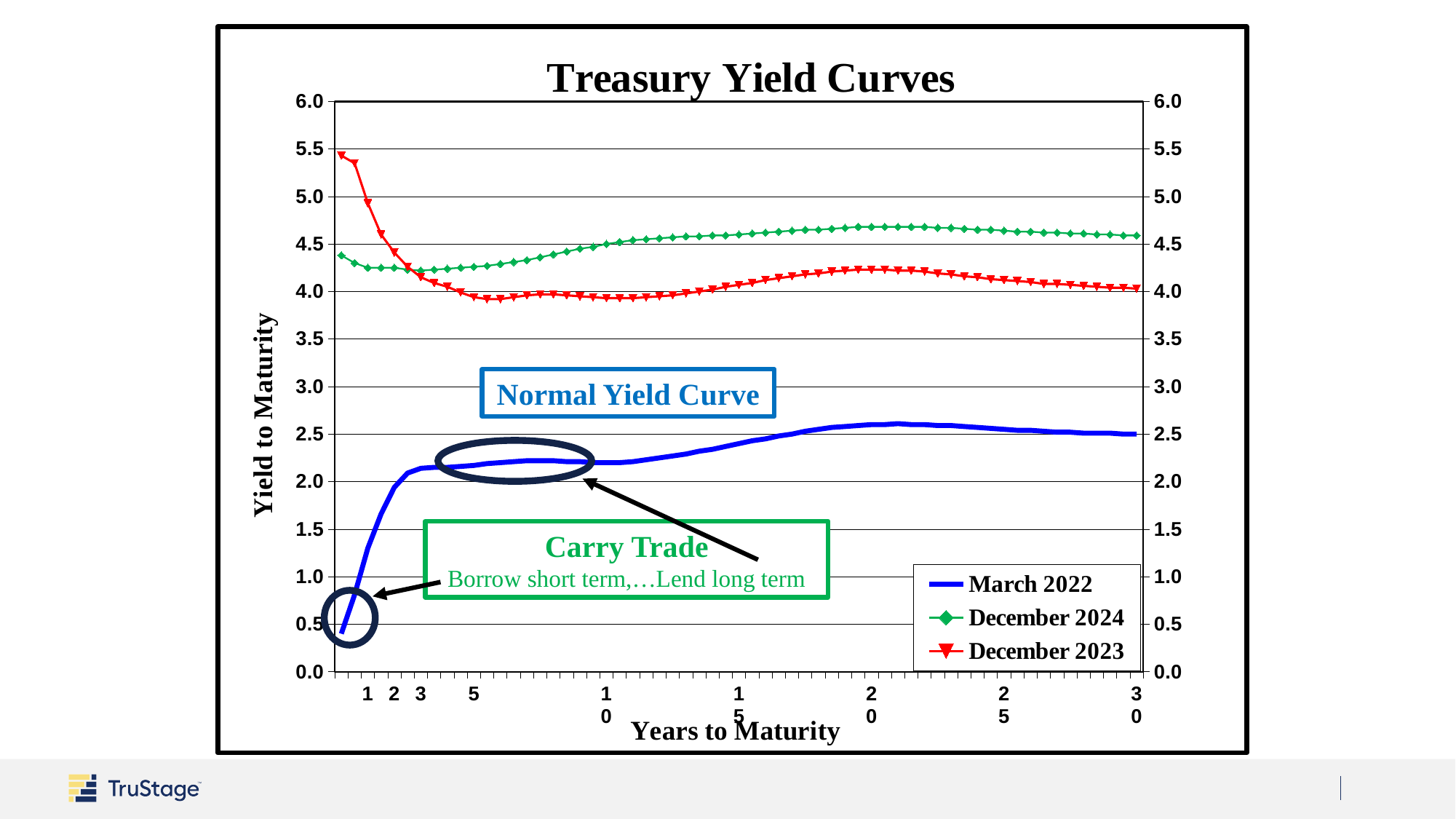
At 1 year to maturity, which is higher: December 2023 or December 2024? December 2023 What is the label on the vertical axis? Yield to Maturity At 30 years to maturity, which is higher: December 2024 or December 2023? December 2024 Does the March 2022 curve rise or fall between 1 and 5 years to maturity? rise What kind of chart is shown on the slide? Line chart Is the December 2024 yield at 30 years to maturity greater or less than 4.0? greater How many series does the legend list? 3 Is the March 2022 yield at 20 years to maturity greater or less than 2.0? greater What is the title of the chart? Treasury Yield Curves Which series has the lowest yields across all maturities? March 2022 Is the December 2023 yield at 5 years to maturity greater or less than 4.5? less Which series has the highest yield at 1 year to maturity? December 2023